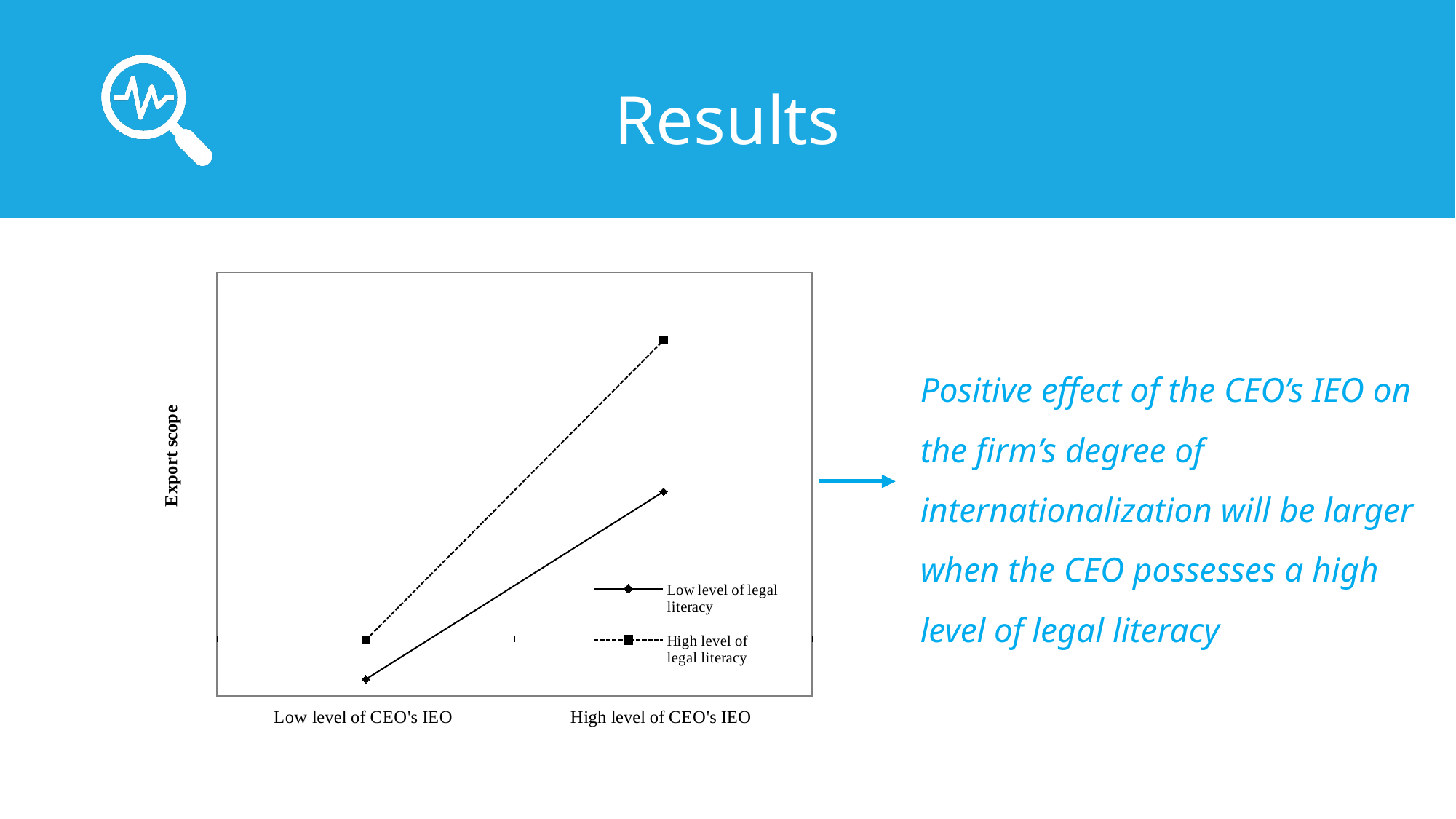
At High level of CEO's IEO, which series has the higher export scope: 'Low level of legal literacy' or 'High level of legal literacy'? High level of legal literacy Does the 'High level of legal literacy' series rise or fall from Low level of CEO's IEO to High level of CEO's IEO? rise What kind of chart is shown on the slide? line chart What are the two categories on the x axis of the chart? Low level of CEO's IEO and High level of CEO's IEO At Low level of CEO's IEO, which series has the lower export scope: 'Low level of legal literacy' or 'High level of legal literacy'? Low level of legal literacy How many categories are shown on the x axis of the chart? 2 Which series shows the steeper increase between the two x-axis categories? High level of legal literacy Does the 'Low level of legal literacy' series rise or fall from Low level of CEO's IEO to High level of CEO's IEO? rise Which series reaches the highest point on the chart? High level of legal literacy Which series has the lowest point on the chart? Low level of legal literacy How many series does the chart's legend list? 2 What is the label of the y axis of the chart? Export scope